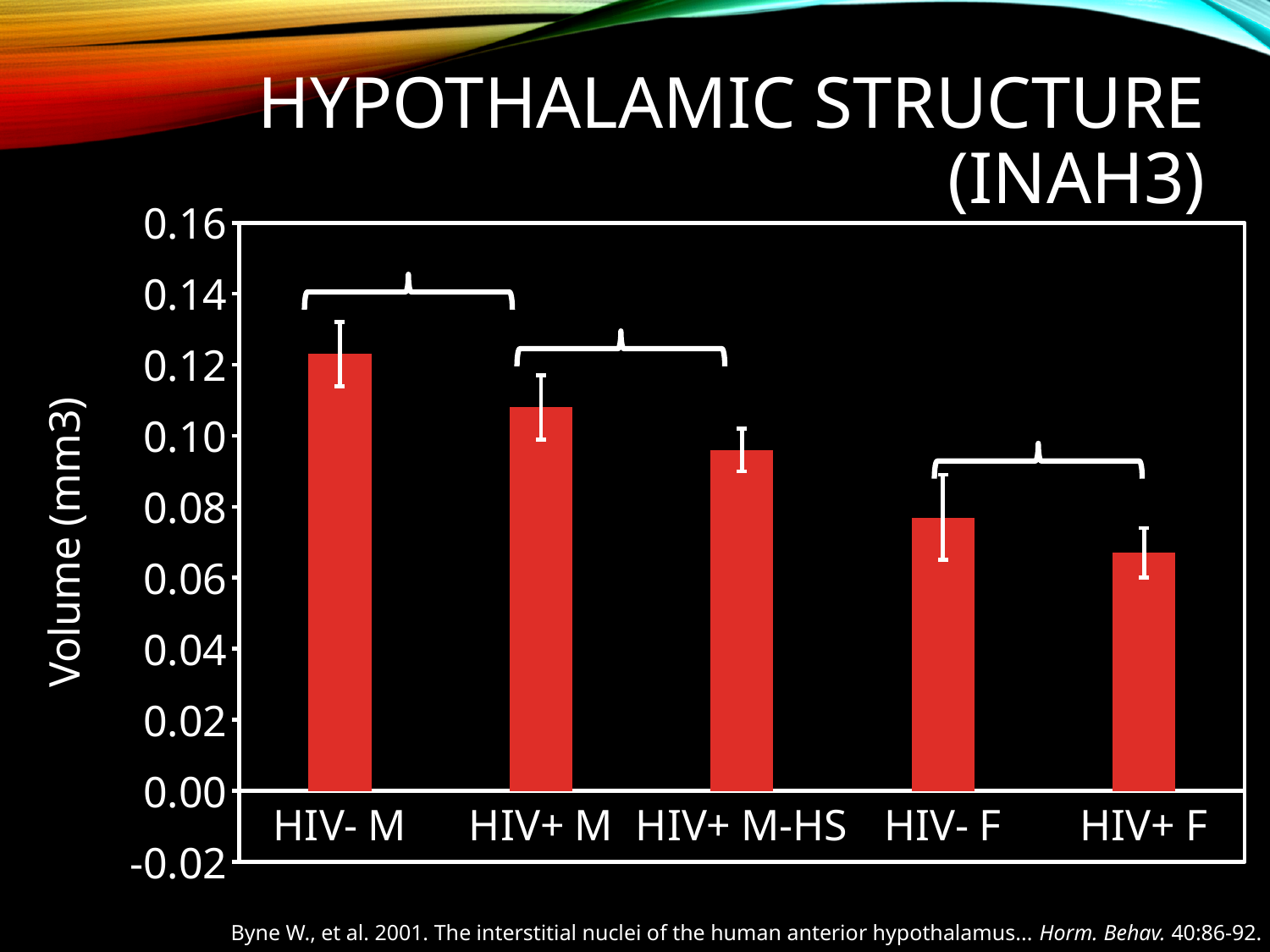
Which is larger, the value for HIV- M or the value for HIV+ M? HIV- M Which category has the lowest volume? HIV+ F Is the value for HIV+ M greater or less than 0.10? greater How many categories are plotted on the x axis? 5 Do the bar values rise or fall from left to right along the x axis? fall Is the value for HIV+ M-HS greater or less than 0.08? greater Is the value for HIV+ F greater or less than 0.08? less Which is larger, the value for HIV- F or the value for HIV+ F? HIV- F What kind of chart is shown on the slide? bar chart Which category has the highest volume? HIV- M What is the label of the y axis? Volume (mm3)